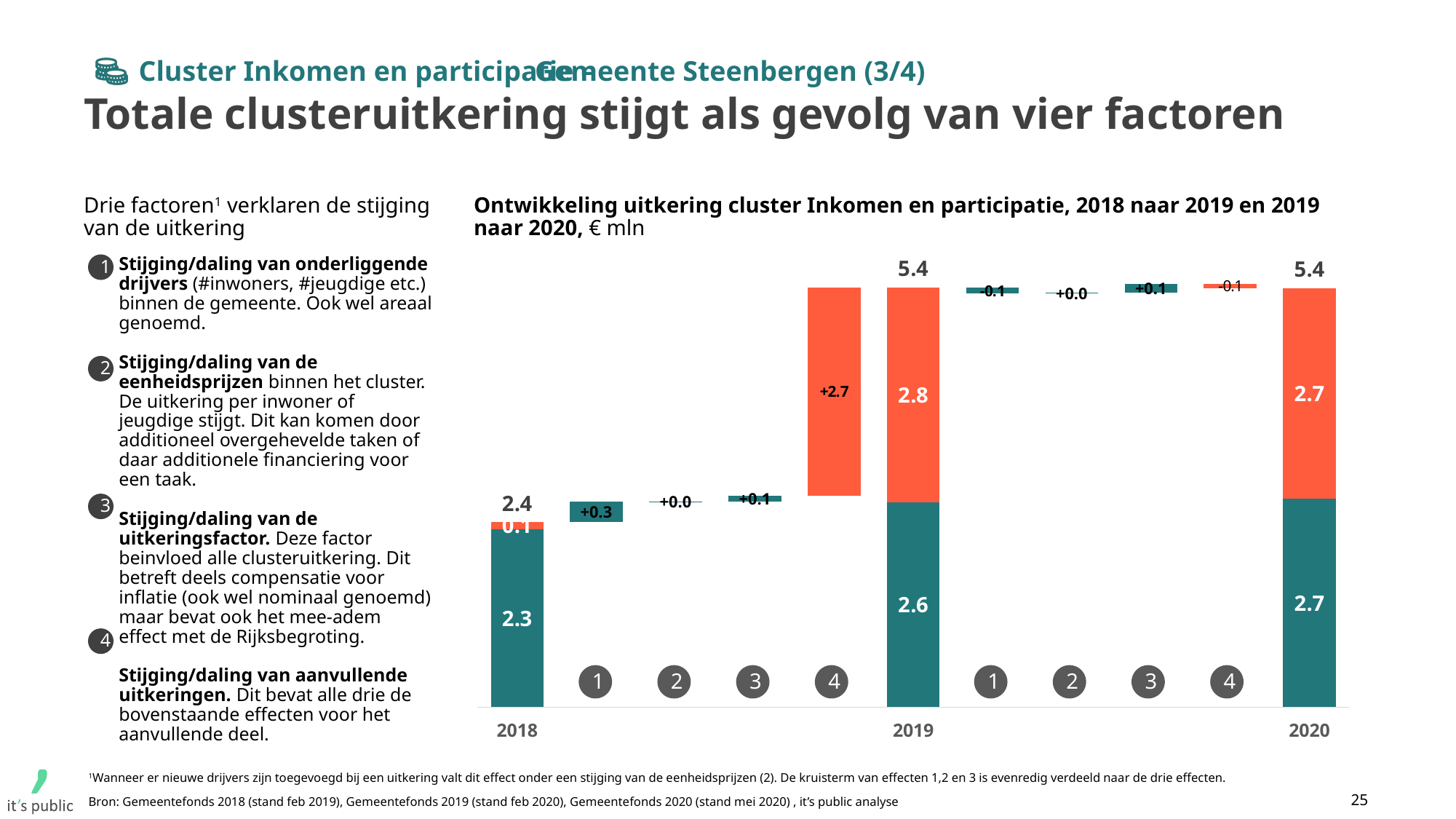
How many year totals (full stacked bars) are shown in the chart? 3 Which of the four steps between 2018 and 2019 has the largest value? 4 (+2.7) What is the total value shown above the 2019 bar? 5.4 What is the difference between the 2019 total (5.4) and the 2018 total (2.4)? 3.0 What unit is stated in the chart title? € mln What is the value of the step labelled 1 between 2019 and 2020? -0.1 What is the value of the orange (upper) segment of the 2019 bar? 2.8 What is the total value shown above the 2018 bar? 2.4 Which is larger, the teal segment of the 2019 bar or the teal segment of the 2018 bar? 2019 (2.6) What is the value of the step labelled 4 between 2018 and 2019? +2.7 What is the value of the teal (lower) segment of the 2020 bar? 2.7 What kind of chart is this? Waterfall (stacked bar) chart